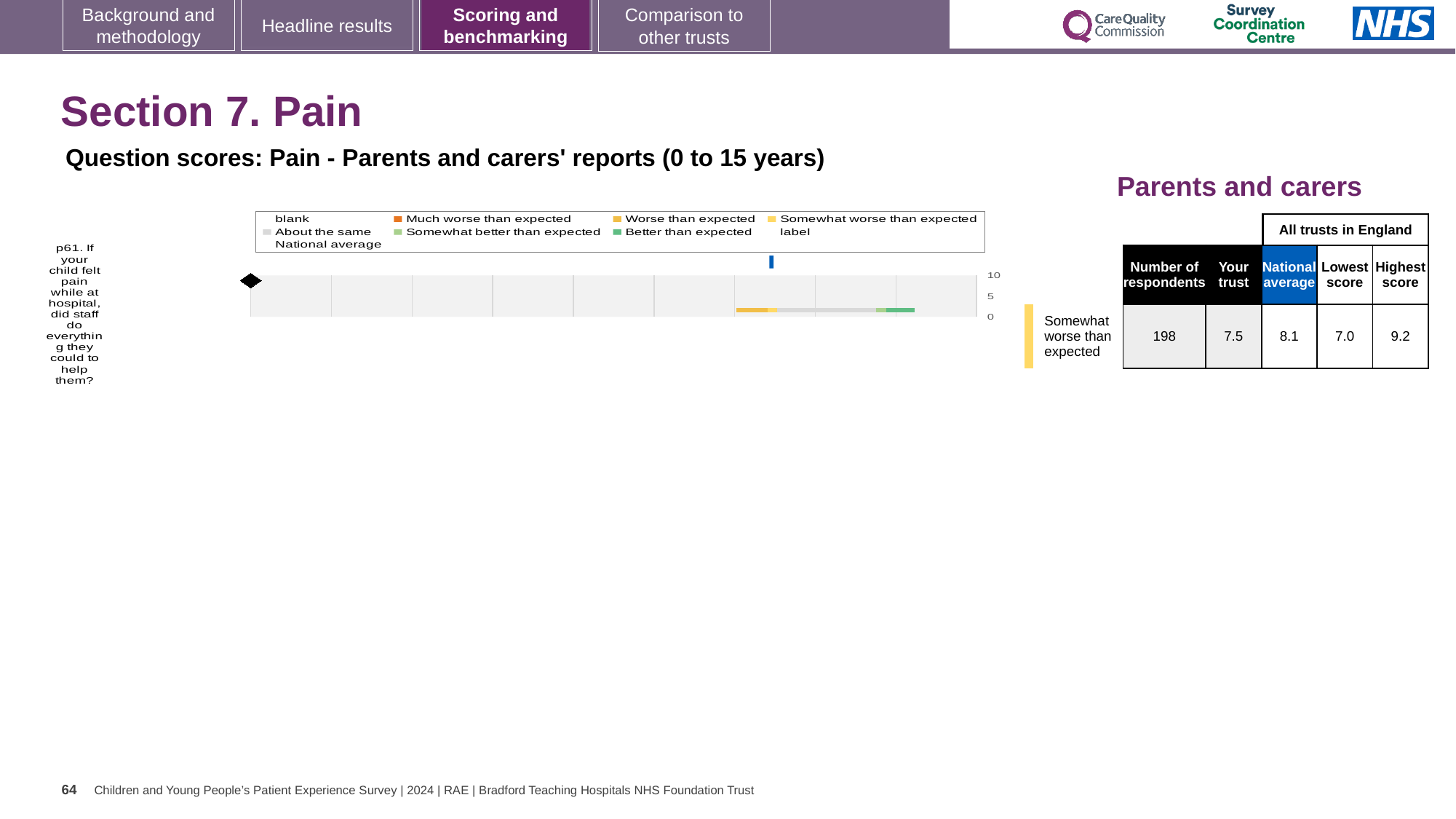
According to the table, how many respondents answered p61? 198 What kind of chart is shown on the slide? bar chart Which legend entry is shown in orange? Much worse than expected Which is larger for p61, the 'Your trust' score or the national average? National average According to the table, what is the 'Your trust' score for p61? 7.5 How many survey questions are plotted in the chart? 1 According to the table, what is the highest score among all trusts in England for p61? 9.2 How many entries does the chart legend list? 9 According to the table, what is the national average score for p61? 8.1 What is the difference between the national average and the 'Your trust' score for p61? 0.6 What is the question number of the item plotted in the chart? p61 What is the highest value shown on the chart's score axis? 10